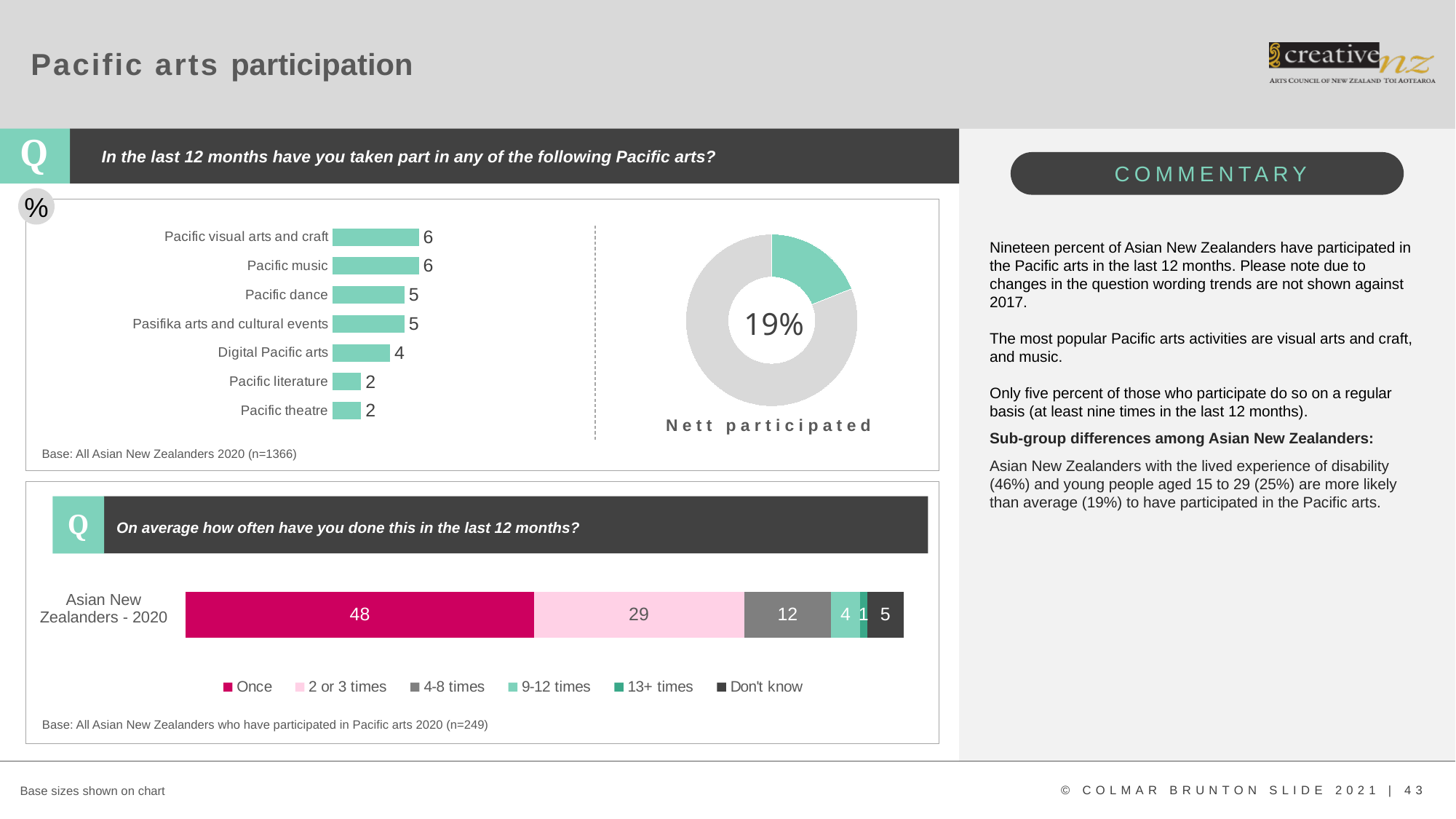
In the bottom stacked bar chart, what is the value for '4-8 times'? 12 In the bottom stacked bar chart, what is the value for 'Once' for Asian New Zealanders - 2020? 48 In the top-left bar chart, what is the value for Digital Pacific arts? 4 In the top-left bar chart, what is the value for Pacific dance? 5 In the bottom stacked bar chart, how many series does the legend list? 6 In the 'Nett participated' donut chart, what percentage is shown in the centre? 19% In the top-left bar chart, how many categories are shown? 7 In the bottom stacked bar chart, what is the total of all segments for Asian New Zealanders - 2020? 99 In the top-left bar chart, what is the value for Pacific theatre? 2 In the top-left bar chart, what is the difference between the values for Pacific music and Pacific literature? 4 In the top-left bar chart, which is larger, the value for Pasifika arts and cultural events or the value for Pacific theatre? Pasifika arts and cultural events What kind of chart is the top-left chart showing Pacific arts activities? Bar chart